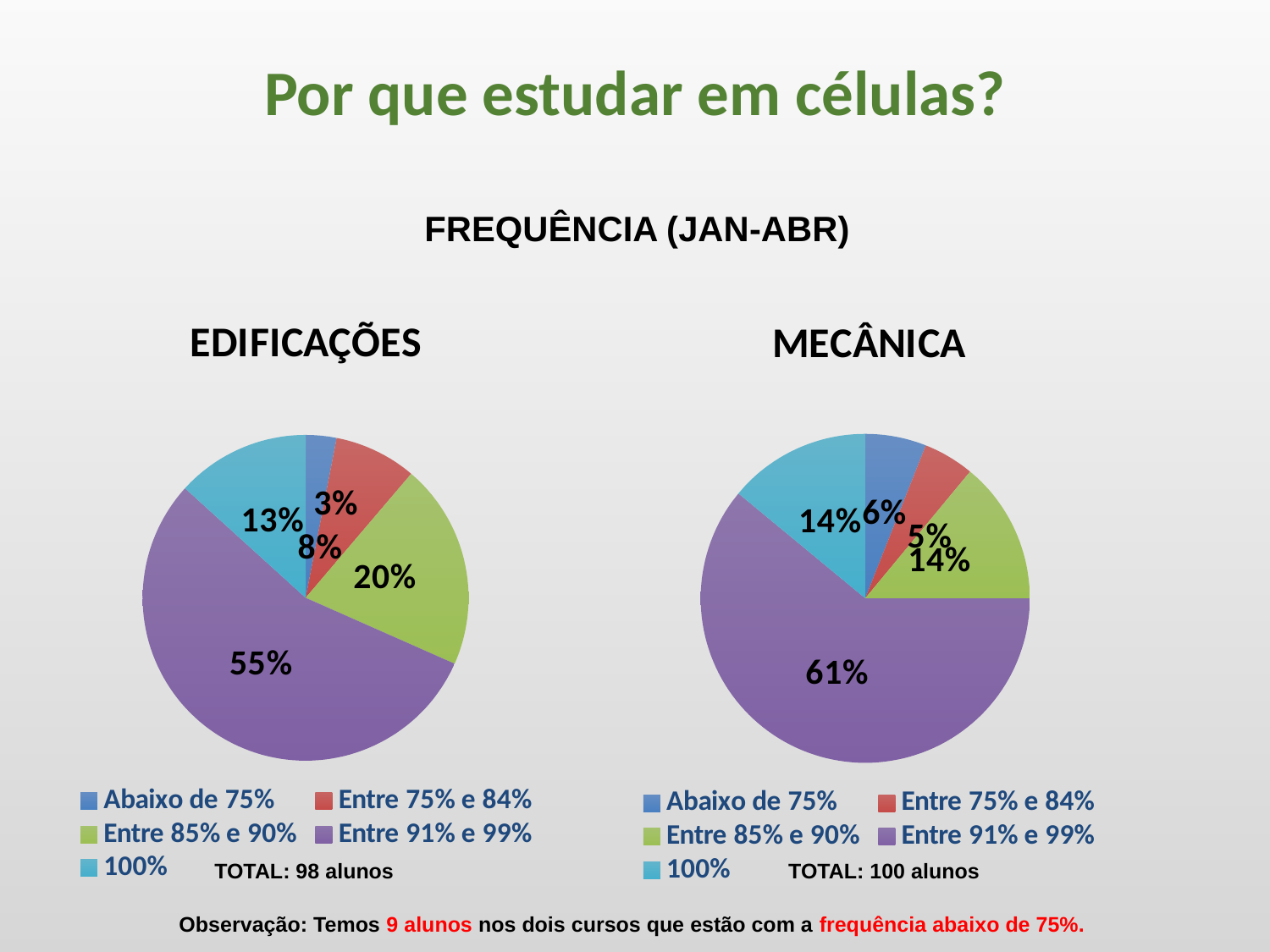
In the EDIFICAÇÕES chart, what percentage is shown for the '100%' slice? 13% In the EDIFICAÇÕES chart, what is the difference between the 'Entre 85% e 90%' slice and the 'Entre 75% e 84%' slice? 12% How many slices does the MECÂNICA pie chart have? 5 What type of chart is used for EDIFICAÇÕES? Pie chart In the EDIFICAÇÕES chart, what percentage is shown for the 'Entre 91% e 99%' slice? 55% In the EDIFICAÇÕES chart, what percentage is shown for the 'Abaixo de 75%' slice? 3% In the MECÂNICA chart, what percentage is shown for the 'Entre 91% e 99%' slice? 61% In the MECÂNICA chart, which category has the largest slice? Entre 91% e 99% In the EDIFICAÇÕES chart, which category has the smallest slice? Abaixo de 75% In the MECÂNICA chart, what percentage is shown for the 'Abaixo de 75%' slice? 6% In the EDIFICAÇÕES chart, which is larger: the 'Entre 85% e 90%' slice or the '100%' slice? Entre 85% e 90% What total number of students is stated below the MECÂNICA chart? 100 alunos